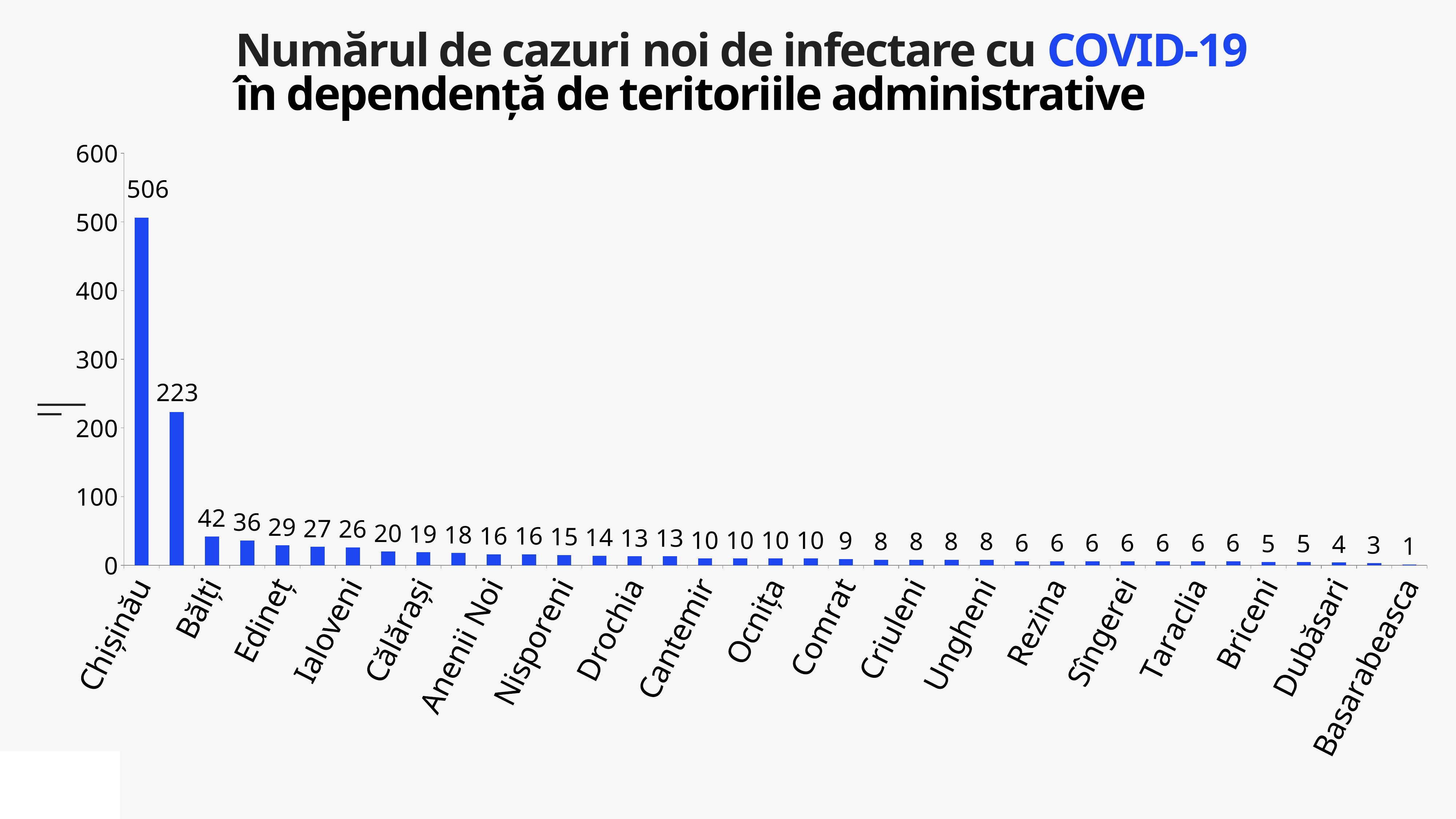
Do the values rise or fall from left to right along the x axis? fall How many new cases are shown for Chișinău? 506 Which territory has the lowest number of new cases? Basarabeasca What type of chart is shown on the slide? bar chart What is the difference between the values for Chișinău and Basarabeasca? 505 How many new cases are shown for Basarabeasca? 1 What is the difference between the highest value (506) and the second-highest value (223)? 283 Is the value for Chișinău greater or less than 400? greater Which territory has the highest number of new COVID-19 cases? Chișinău What colour are the bars in the chart? blue Which has more new cases, Chișinău or Basarabeasca? Chișinău What is the second-highest value labelled on the chart? 223